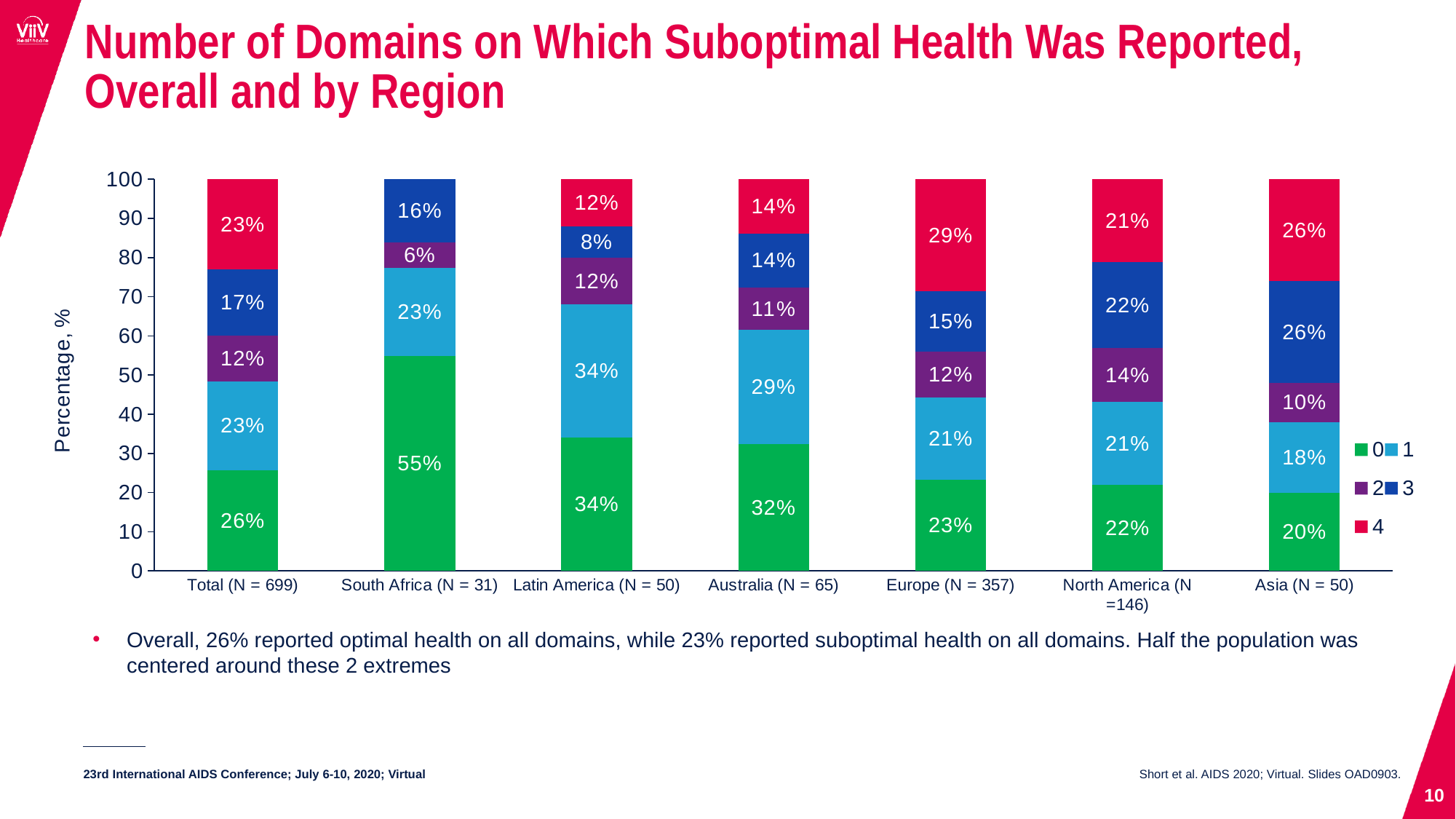
What is the label of the y axis? Percentage, % What is the value for series 4 in Europe (N = 357)? 29% What percentage of the Total (N = 699) group reported suboptimal health on 0 domains? 26% Which category has the lowest value for series 0? Asia (N = 50) What kind of chart is shown on the slide? Stacked bar chart What is the difference between the series 0 value for South Africa (N = 31) and for Asia (N = 50)? 35% How many categories (bars) are shown on the x axis? 7 Which is larger: the series 4 value for Europe (N = 357) or for Australia (N = 65)? Europe (N = 357) How many series does the legend list? 5 Which region has the highest value for series 0? South Africa (N = 31) What is the value for series 1 in Latin America (N = 50)? 34% What is the value for series 3 in North America (N =146)? 22%